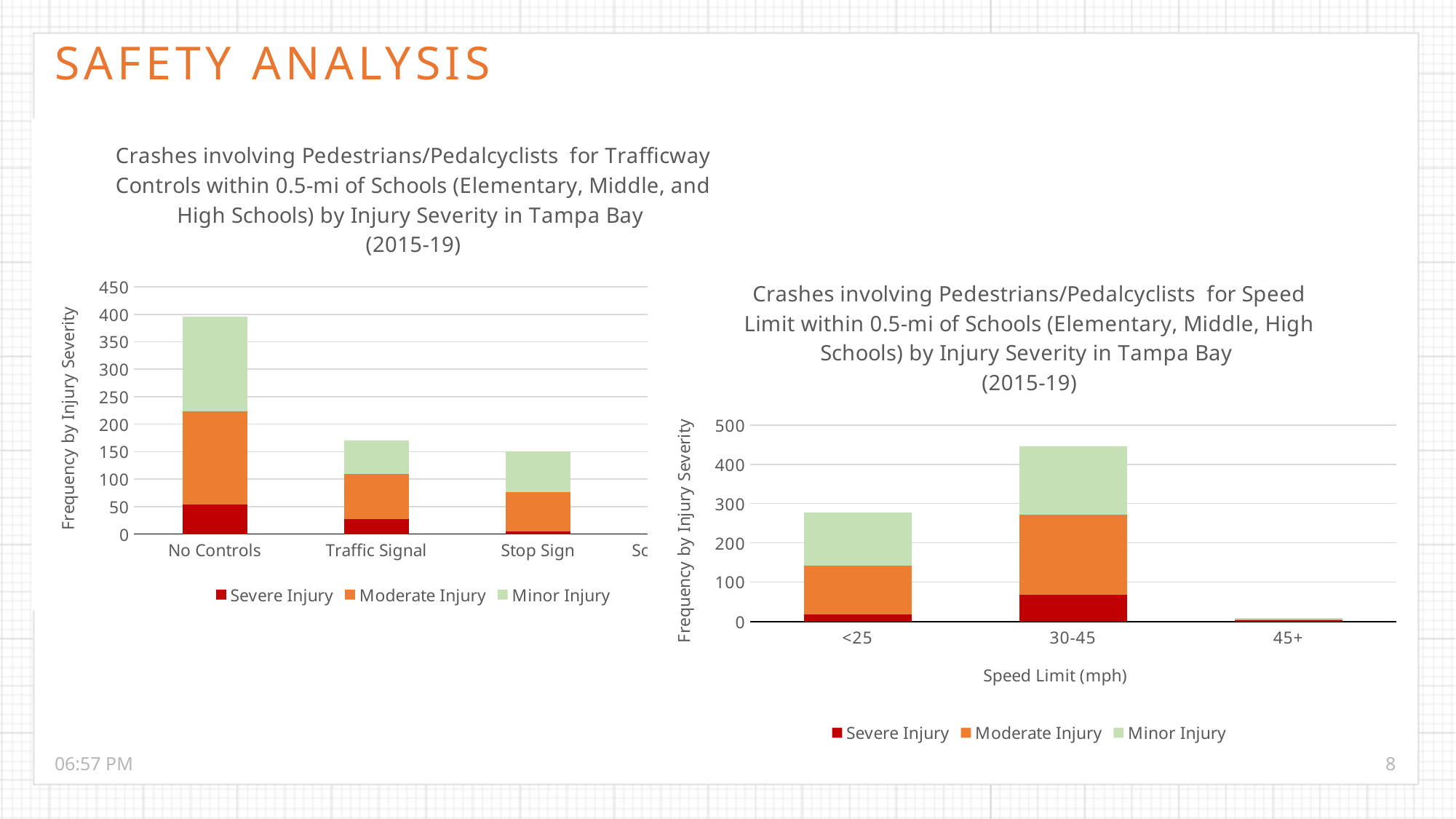
In the Speed Limit chart on the right, how many series does the legend list? 3 In the Speed Limit chart on the right, which has a larger total frequency, <25 or 30-45? 30-45 What kind of chart is the chart on the left about Trafficway Controls? Stacked bar chart In the Trafficway Controls chart on the left, is the total frequency for No Controls greater or less than 350? greater In the Speed Limit chart on the right, is the total frequency for 30-45 greater or less than 400? greater In the Speed Limit chart on the right, which speed limit category has the highest total frequency? 30-45 In the Trafficway Controls chart on the left, which has a larger total frequency, No Controls or Traffic Signal? No Controls In the Speed Limit chart on the right, how many speed limit categories are shown on the x axis? 3 What is the x-axis title of the Speed Limit chart on the right? Speed Limit (mph) In the Speed Limit chart on the right, which speed limit category has the lowest total frequency? 45+ In the Speed Limit chart on the right, is the total frequency for <25 greater or less than 300? less In the Trafficway Controls chart on the left, which category has the highest total frequency? No Controls